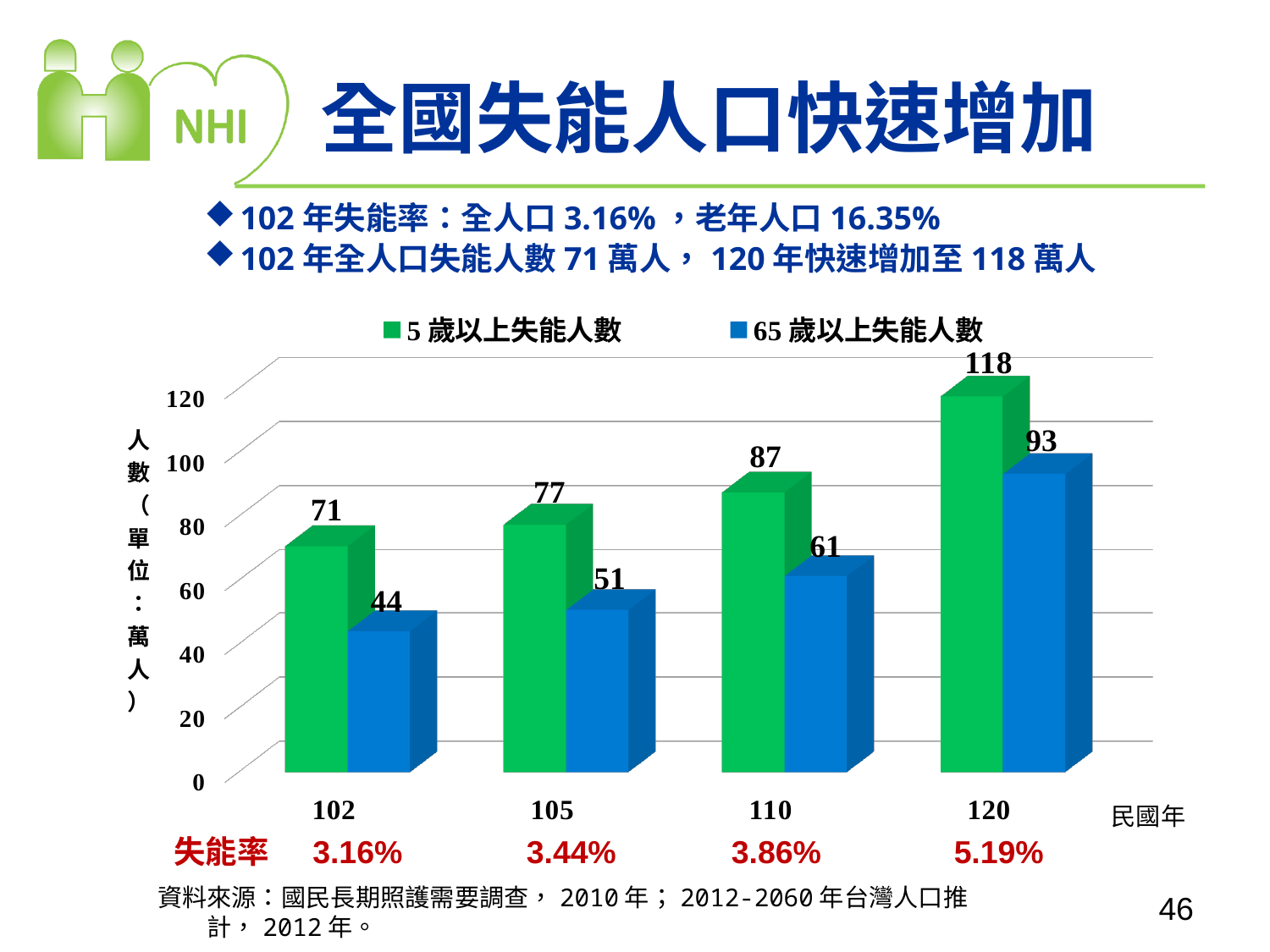
What is the value for 65歲以上失能人數 in year 110? 61 What colour are the bars for 65歲以上失能人數? blue How many series does the legend list? 2 What is the value for 5歲以上失能人數 in year 102? 71 Which year has the highest value for 5歲以上失能人數? 120 Which year has the lowest value for 65歲以上失能人數? 102 Do the values for 65歲以上失能人數 rise or fall from year 102 to year 120? rise What kind of chart is shown? bar chart Which is larger: 5歲以上失能人數 in year 110 or 65歲以上失能人數 in year 120? 65歲以上失能人數 in year 120 How many years are shown on the x axis? 4 What is the value for 65歲以上失能人數 in year 120? 93 What is the difference between 5歲以上失能人數 and 65歲以上失能人數 in year 105? 26